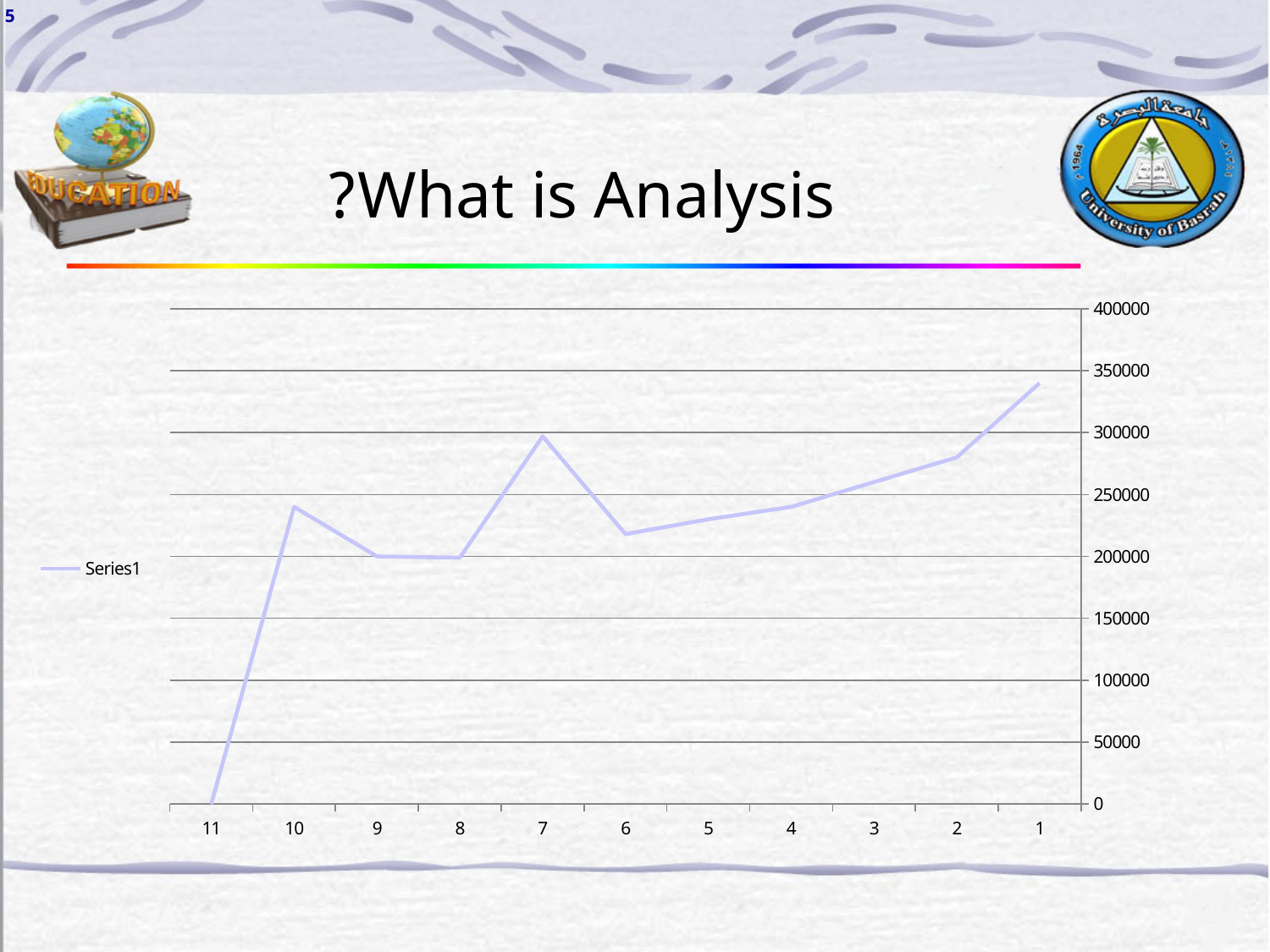
Is the value for category 7 greater or less than 250000? greater Which has the larger value, category 7 or category 6? 7 Which category has the highest value? 1 Do the values generally rise or fall moving along the x axis from 11 to 1? rise Which category has the lowest value? 11 What is the name of the series shown in the legend? Series1 Is the value for category 1 greater or less than 300000? greater How many series does the legend list? 1 Is the value for category 10 greater or less than 200000? greater How many categories are shown on the x axis? 11 What kind of chart is shown on the slide? line chart What is the value for category 11? 0